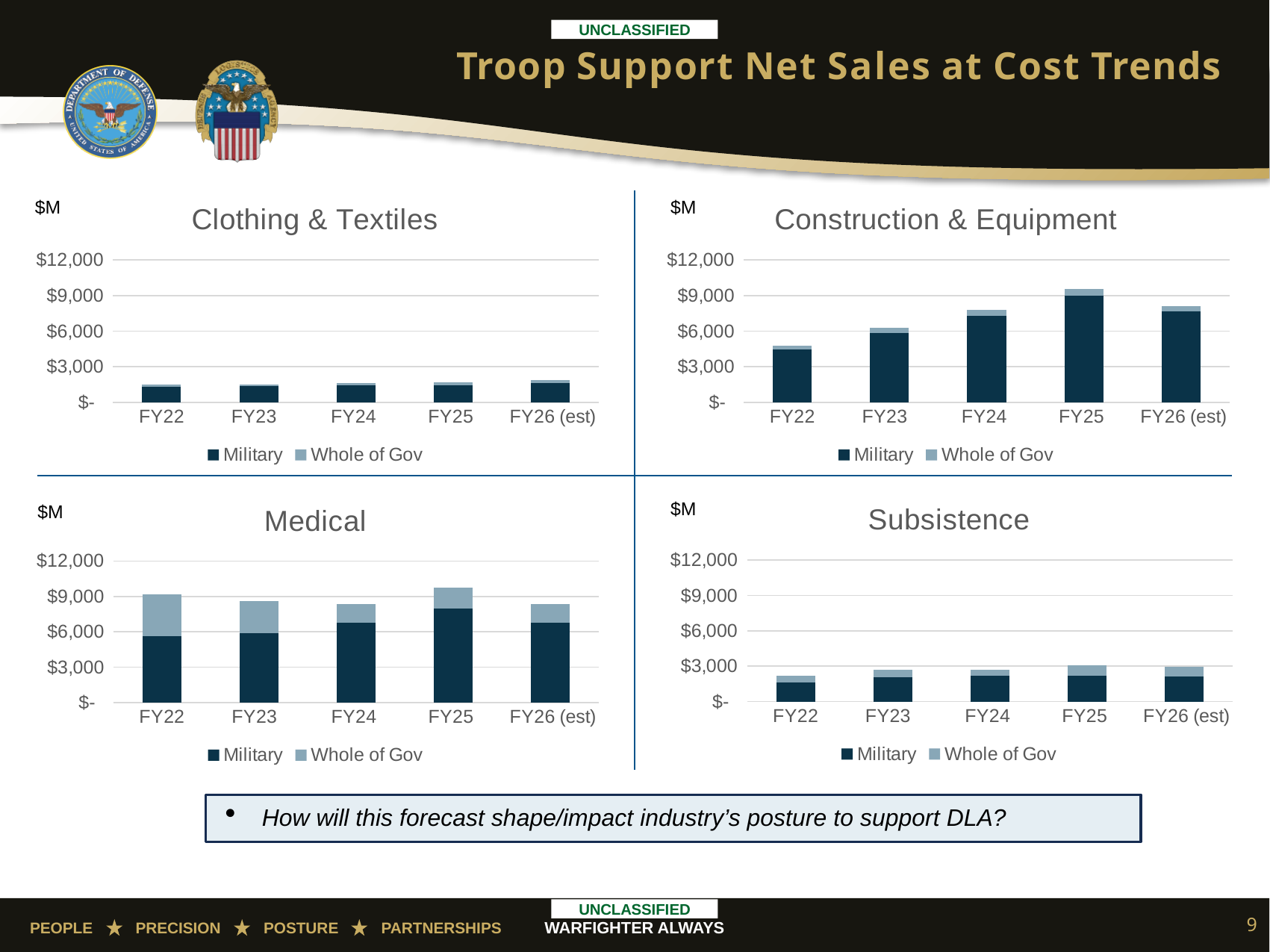
In the Construction & Equipment chart, which fiscal year has the highest total bar? FY25 In the Construction & Equipment chart, is the total value for FY22 greater or less than $6,000? less How many fiscal years are shown on the x axis of the Medical chart? 5 What are the two legend entries in the Medical chart? Military and Whole of Gov In the Medical chart, which fiscal year has the largest Military segment? FY25 What kind of chart is the Clothing & Textiles chart? bar chart In the Subsistence chart, which fiscal year has the lowest total bar? FY22 In the Construction & Equipment chart, do the total bars rise or fall from FY22 to FY25? rise How many series does the legend of the Subsistence chart list? 2 In the Construction & Equipment chart, which fiscal year has the lowest total bar? FY22 In the Clothing & Textiles chart, is the total value for FY24 greater or less than $3,000? less In the Construction & Equipment chart, is the total value for FY25 greater or less than $9,000? greater